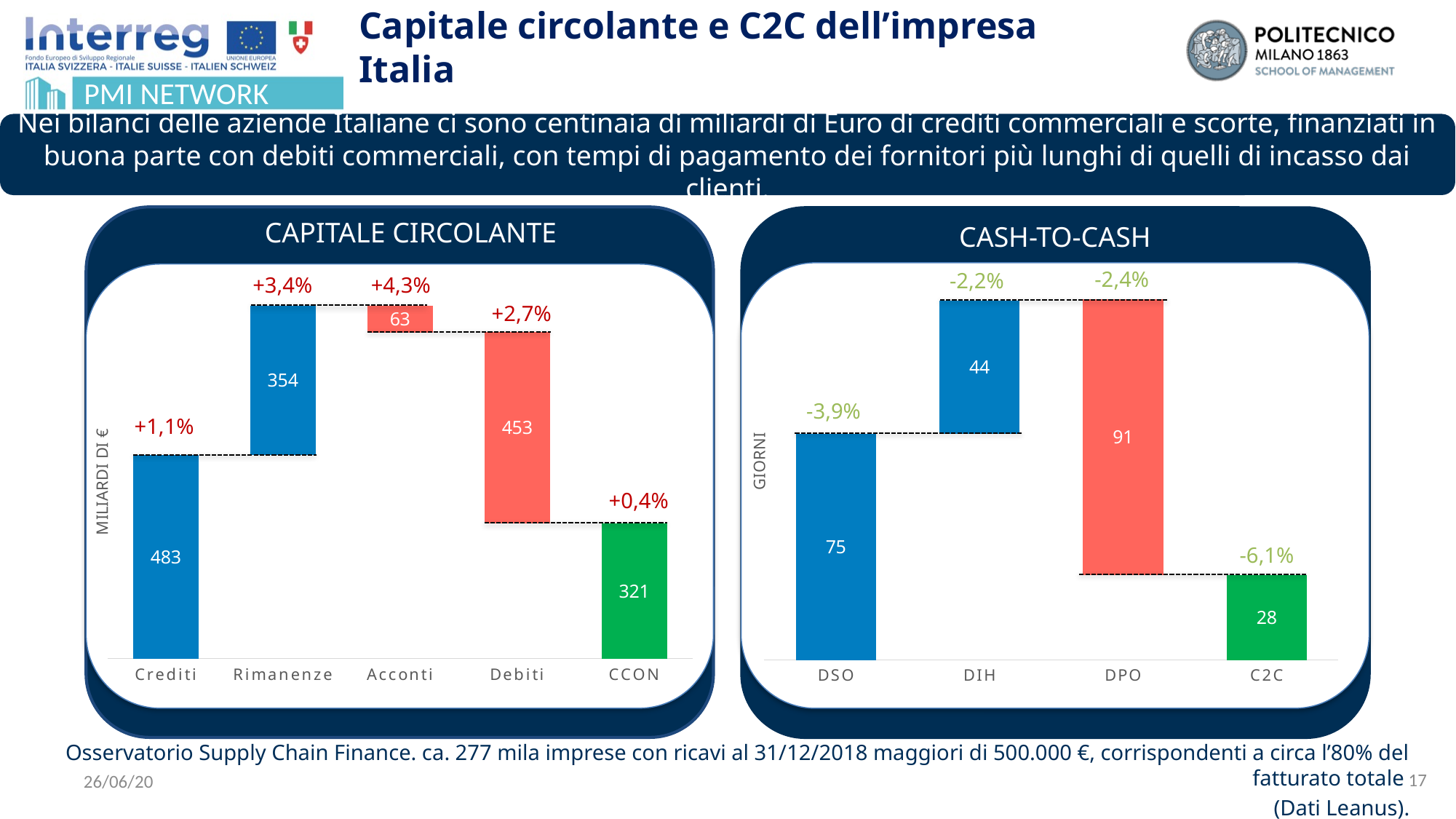
In the CAPITALE CIRCOLANTE chart, what is the difference between Crediti and Debiti? 30 In the CASH-TO-CASH chart, what is the value for C2C? 28 In the CAPITALE CIRCOLANTE chart, what is the value for Acconti? 63 In the CASH-TO-CASH chart, what percentage change is shown above the C2C bar? -6,1% In the CAPITALE CIRCOLANTE chart, what percentage change is shown above the Acconti bar? +4,3% In the CAPITALE CIRCOLANTE chart, how many categories are shown on the x axis? 5 In the CAPITALE CIRCOLANTE chart, what is the value for Crediti? 483 In the CASH-TO-CASH chart, what is the value for DPO? 91 In the CAPITALE CIRCOLANTE chart, what is the value for Rimanenze? 354 What is the y-axis label of the CASH-TO-CASH chart? GIORNI In the CAPITALE CIRCOLANTE chart, which category has the lowest value? Acconti In the CASH-TO-CASH chart, which is larger, DSO or DIH? DSO